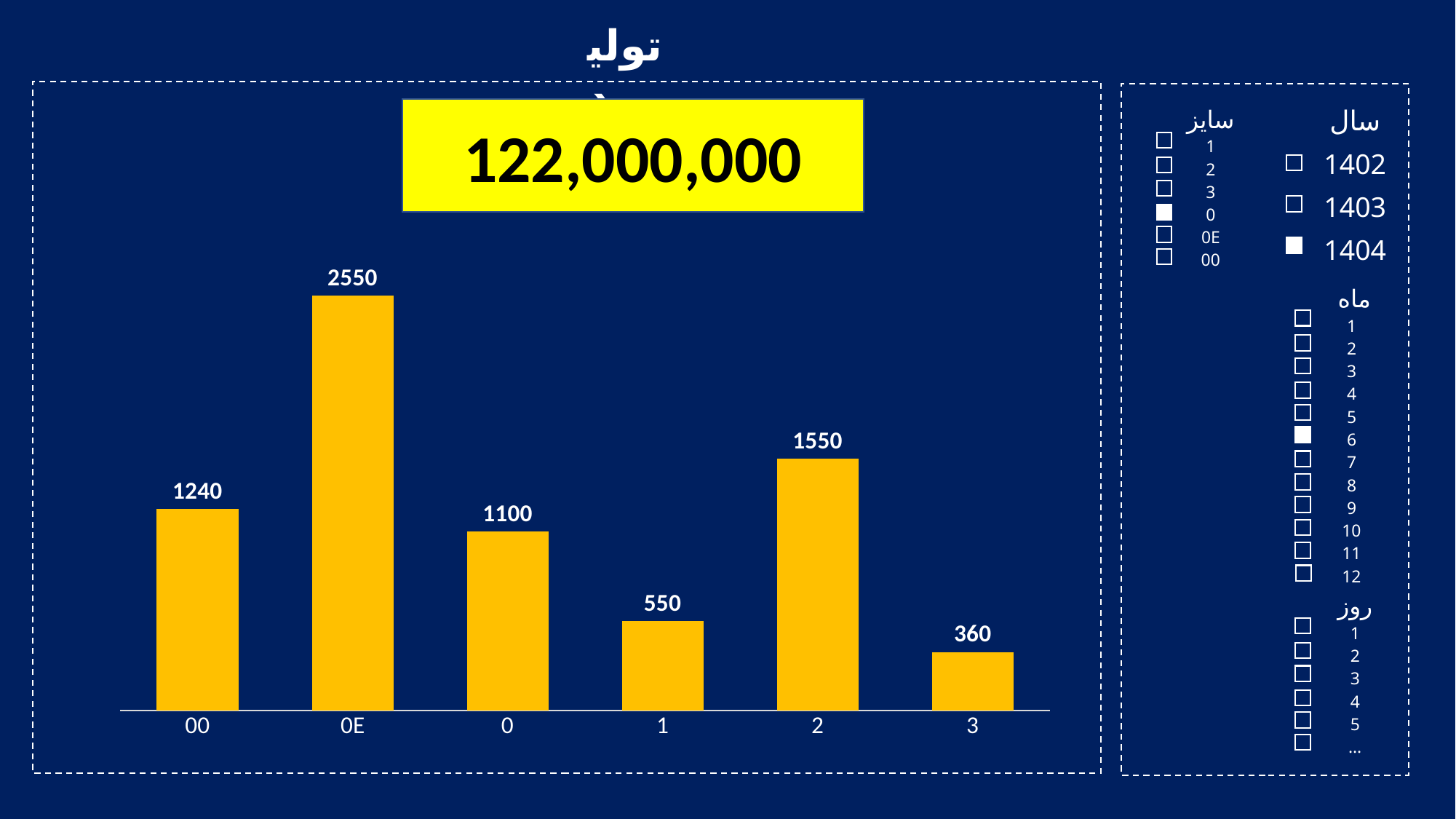
Which category has the lowest value? 3 What is the value for category 0E? 2550 Which is larger, the value for 00 or the value for 0? 00 What is the difference between the values for 0 and 1? 550 What is the value for category 1? 550 What is the value for category 3? 360 What kind of chart is shown? bar chart How many categories are shown on the x axis? 6 What is the value for category 00? 1240 What is the difference between the values for 0E and 2? 1000 What number is shown in the yellow box above the chart? 122,000,000 Which category has the highest value? 0E